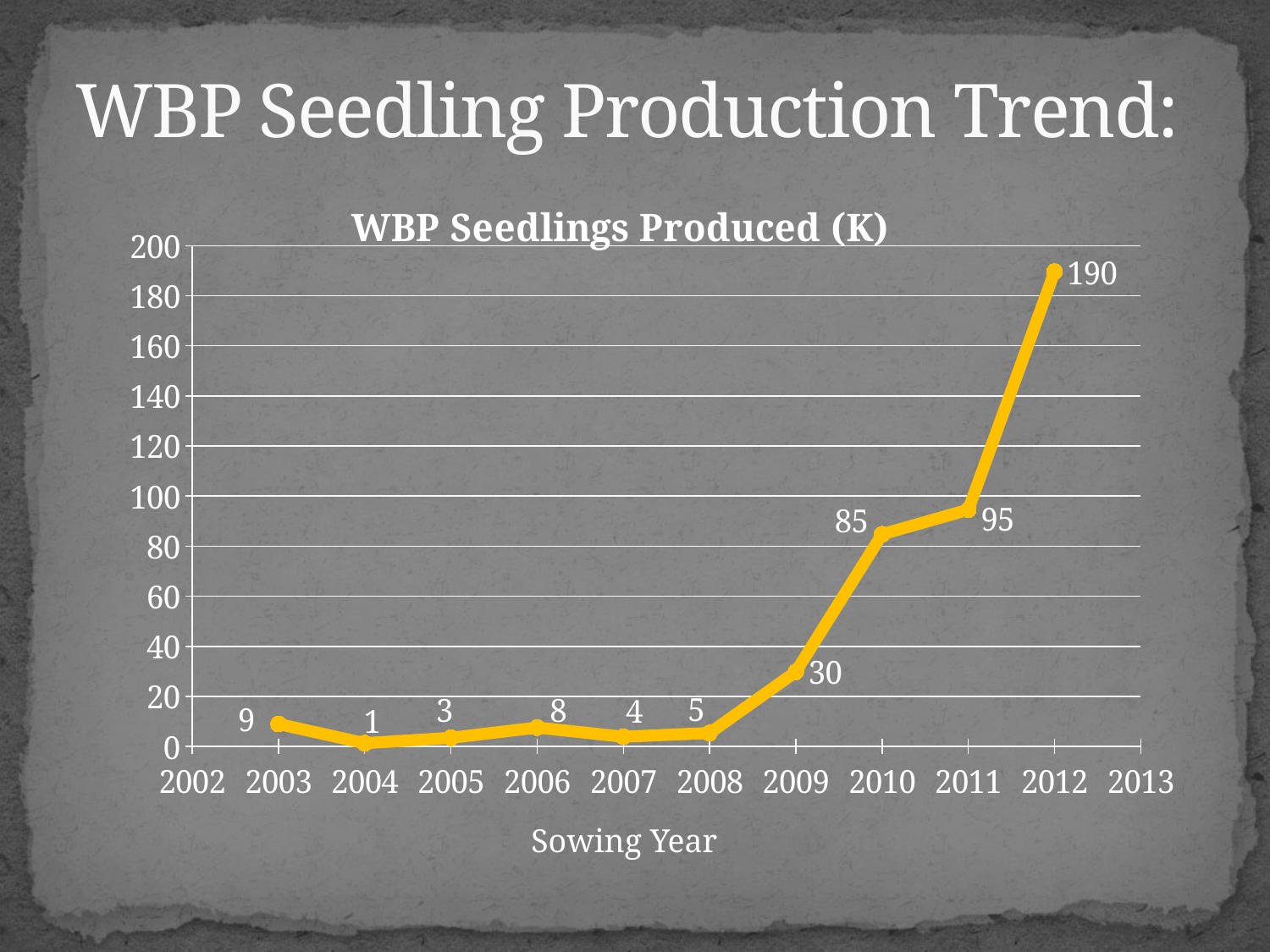
Which sowing year has the lowest value? 2004 Which is larger, the value for 2010 or the value for 2011? 2011 Which sowing year has the highest value? 2012 What is the difference between the values for 2012 and 2011? 95 What kind of chart is shown? line chart What is the value for 2004? 1 What is the title of the chart? WBP Seedlings Produced (K) Is the value for 2010 greater or less than 100? less Do the values generally rise or fall from 2008 to 2012? rise What is the value for 2012? 190 How many data points are plotted on the chart? 10 What is the value for 2009? 30